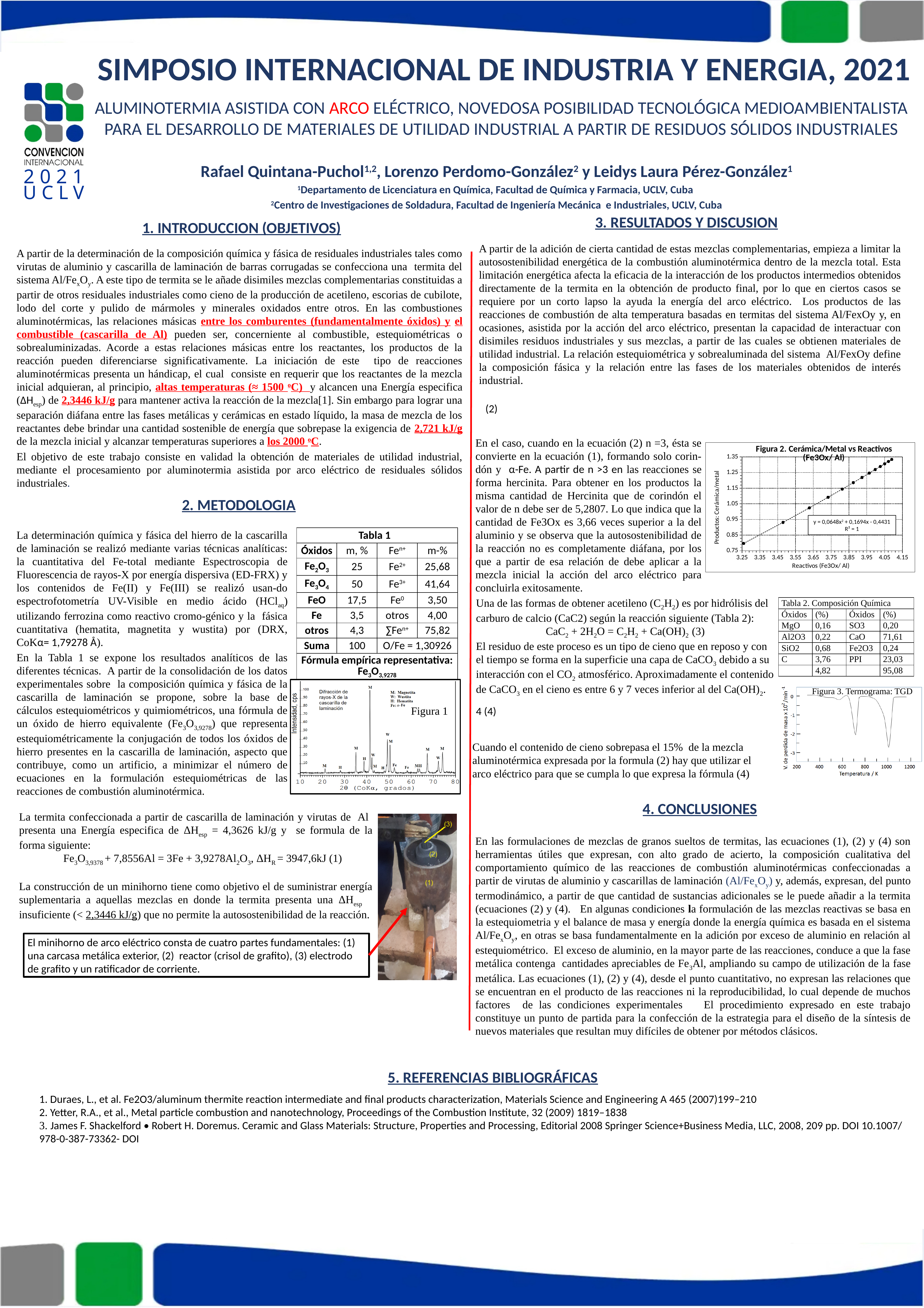
What kind of chart is Figura 1 (the X-ray diffraction pattern of the mill scale)? line chart In Figura 2, do the Cerámica/metal values rise or fall as the Reactivos (Fe3Ox/Al) ratio increases? rise What kind of chart is Figura 2 (Cerámica/Metal vs Reactivos)? scatter chart In Figura 2, is the Cerámica/metal value at a Reactivos ratio of 4.05 greater or less than 1.25? greater In Figura 1, what phase does the label M stand for according to the legend? Magnetita In Figura 2, what R² value is printed for the fitted trendline? 1 In Figura 2, is the Cerámica/metal value at a Reactivos ratio of 3.25 greater or less than 0.85? less What kind of chart is Figura 3 (Termograma: TGD)? line chart In Figura 2, what trendline equation is printed on the chart? y = 0,0648x² + 0,1694x - 0,4431